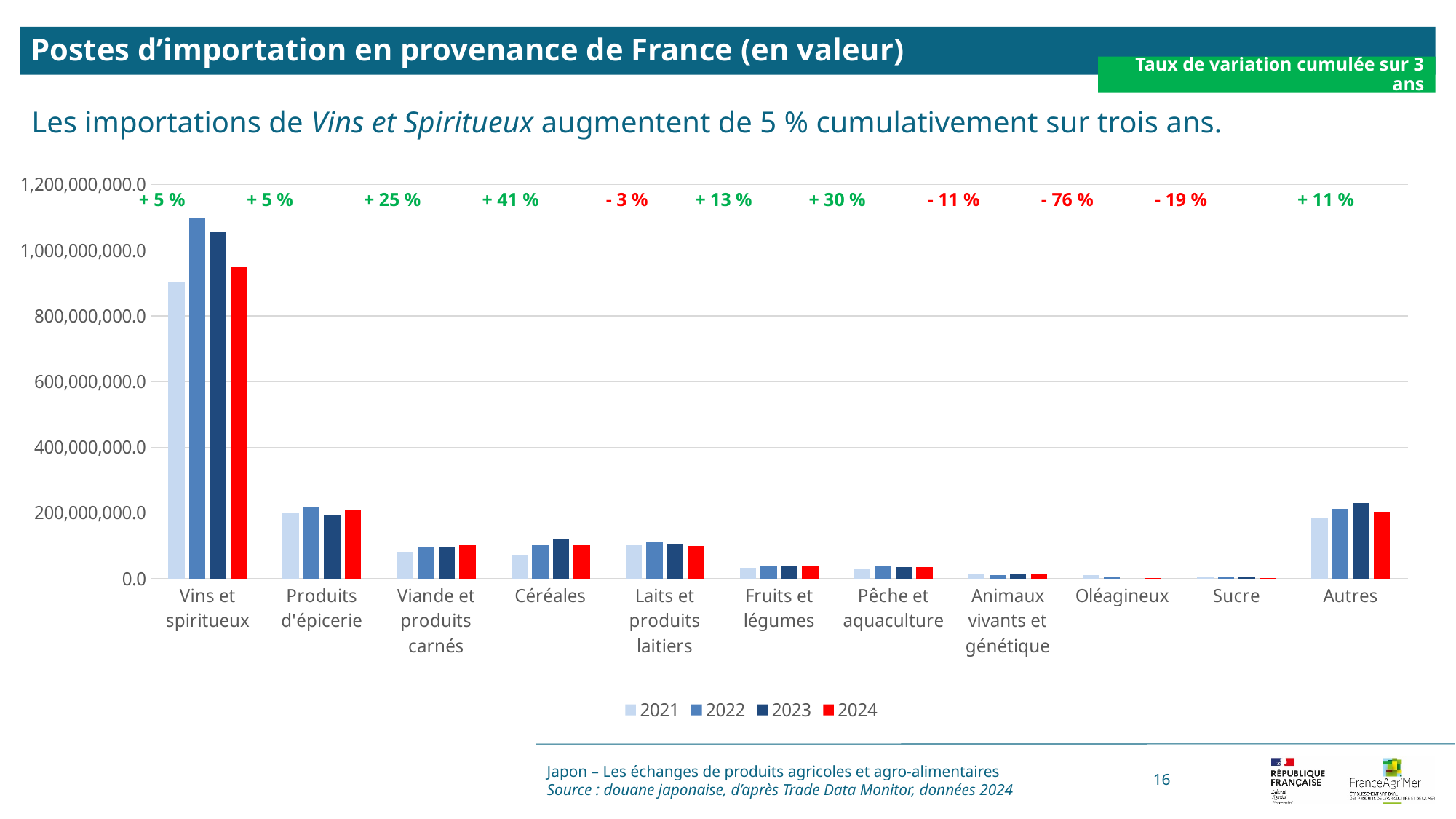
Which category shows the largest cumulative variation rate over 3 years? Céréales For Vins et spiritueux, which is larger: the 2022 bar or the 2024 bar? 2022 Is the 2024 value for Vins et spiritueux greater or less than 800,000,000.0? greater What is the cumulative variation rate over 3 years printed above Céréales? + 41 % What is the cumulative variation rate over 3 years printed above Oléagineux? - 76 % Which colour represents the 2024 series in the legend? red What is the cumulative variation rate over 3 years printed above Pêche et aquaculture? + 30 % How many series does the chart legend list? 4 Is the 2023 value for Céréales greater or less than 200,000,000.0? less What kind of chart is shown on the slide? bar chart How many product categories are shown on the x axis of the chart? 11 Which product category has the highest import values in the chart? Vins et spiritueux